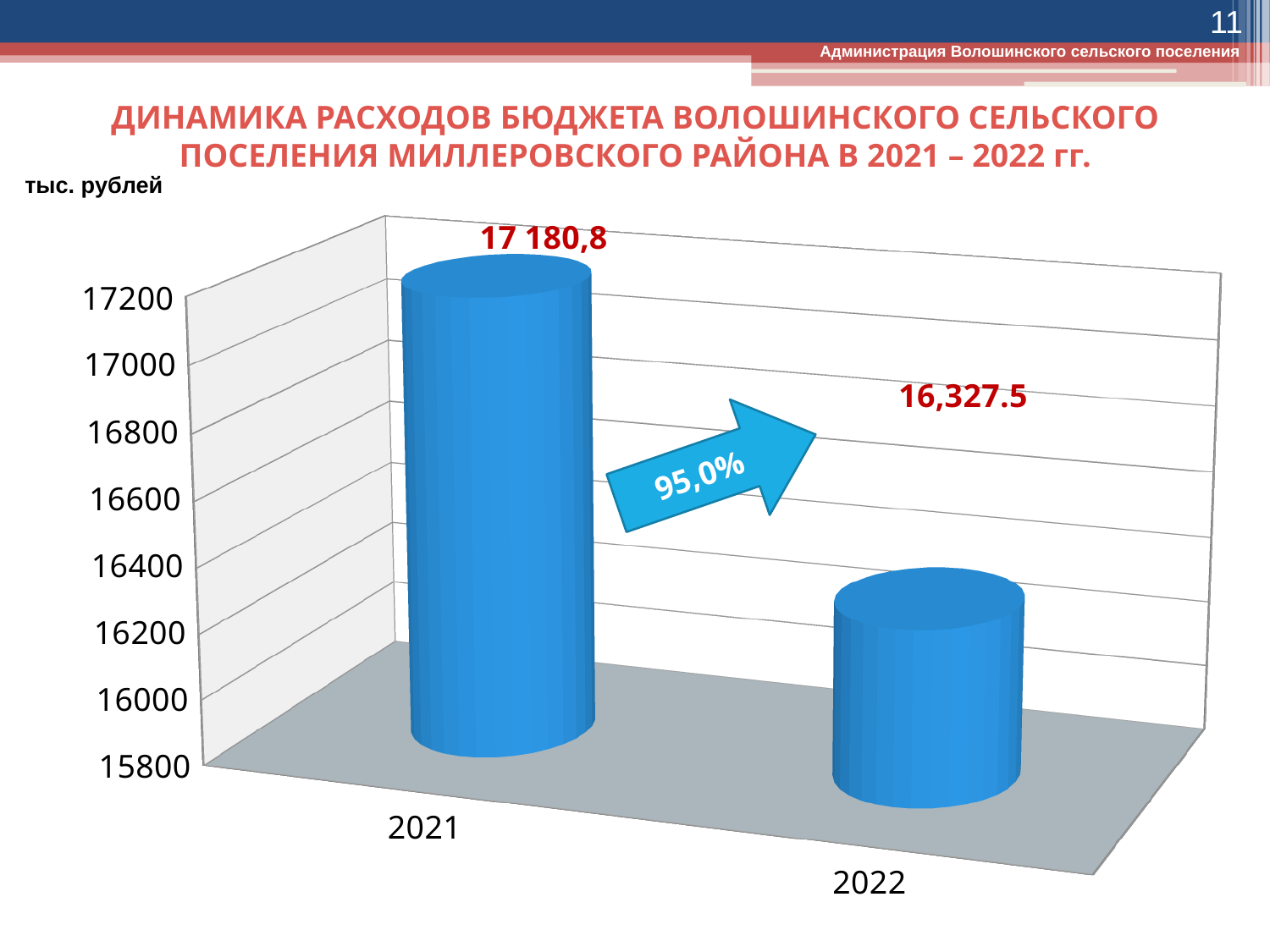
Which year has the lowest value? 2022 What is the value for 2022? 16,327.5 What kind of chart is shown on the slide? bar chart Is the value for 2022 greater or less than 16400? less Do the values rise or fall from 2021 to 2022? fall What is the value for 2021? 17 180,8 How many categories (years) are shown on the chart? 2 What percentage is shown on the arrow between the two bars? 95,0% What is the difference between the 2021 value and the 2022 value? 853,3 Which is larger, the value for 2021 or the value for 2022? 2021 Is the value for 2021 greater or less than 17000? greater Which year has the highest value? 2021